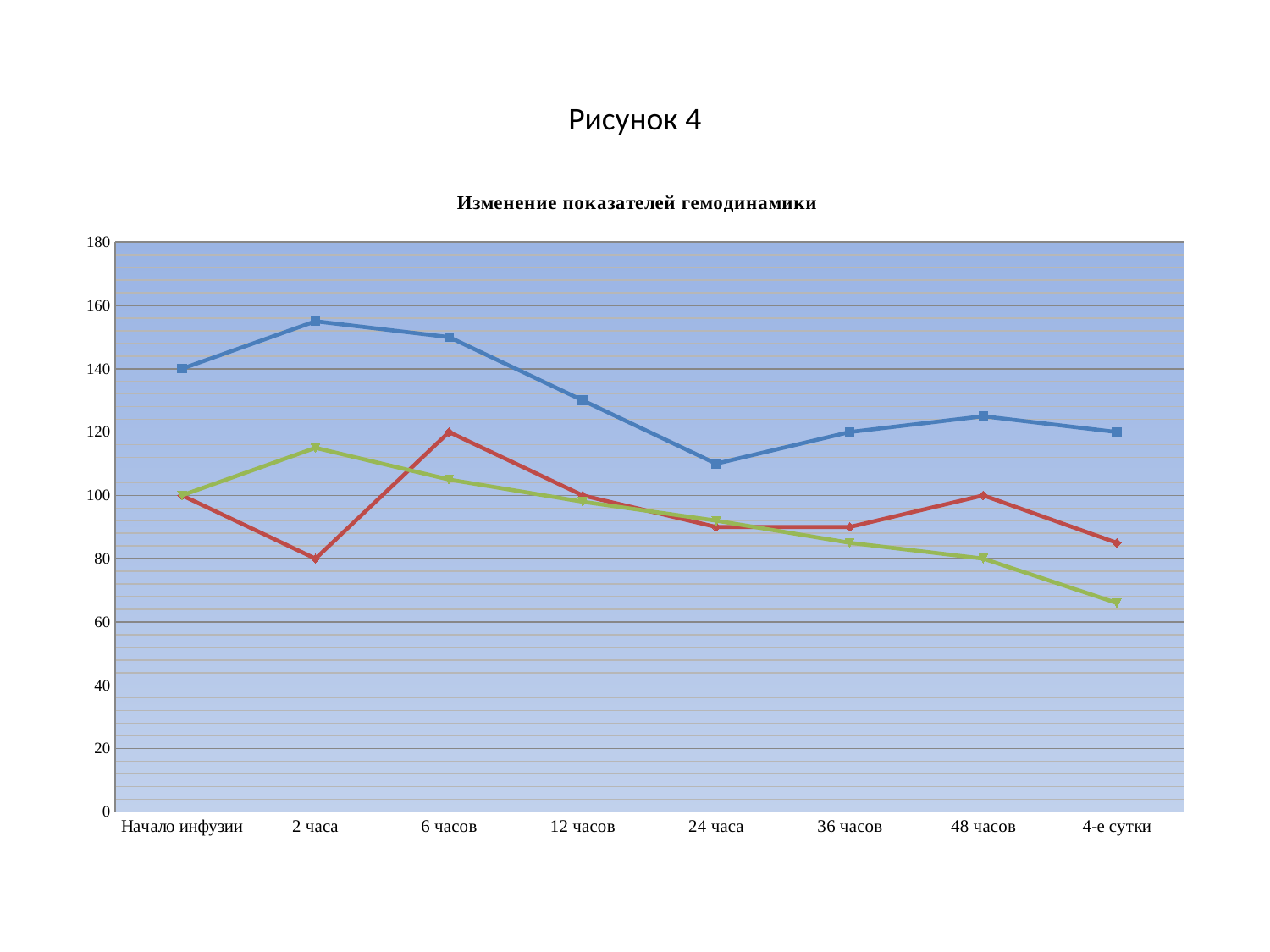
What is the value of the green line at 48 часов? 80 Which line has the higher value at 4-е сутки, the red line or the green line? red line How many time points are shown along the x axis? 8 What kind of chart is shown on the slide? line chart At which time point does the green line reach its lowest value? 4-е сутки At which time point does the blue line reach its highest value? 2 часа How many lines (series) are plotted on the chart? 3 What is the title of the chart? Изменение показателей гемодинамики Is the value of the blue line at 24 часа greater or less than 120? less What is the value of the red line at 6 часов? 120 What is the value of the blue line at Начало инфузии? 140 Is the value of the green line at 2 часа greater or less than 100? greater